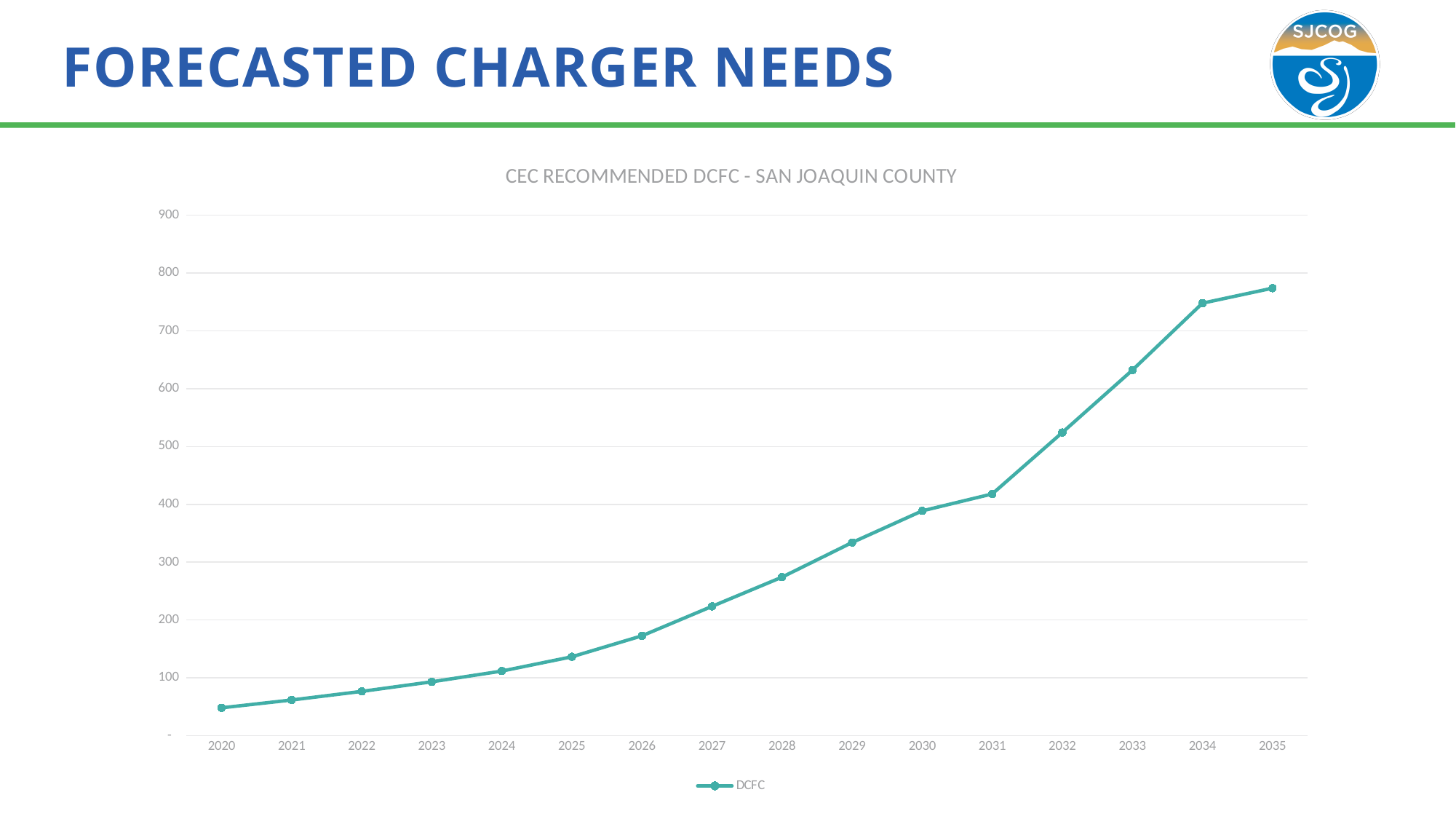
Which year has the lowest DCFC value? 2020 Is the DCFC value for 2028 greater or less than 300? less How many series does the legend list? 1 Is the DCFC value for 2035 greater or less than 700? greater Is the DCFC value for 2032 greater or less than 500? greater Which year has the larger DCFC value, 2031 or 2033? 2033 What is the title of the chart? CEC RECOMMENDED DCFC - SAN JOAQUIN COUNTY How many years are plotted along the x axis? 16 Do the DCFC values rise or fall from 2020 to 2035? rise Which year has the highest DCFC value? 2035 What kind of chart is shown on the slide? line chart